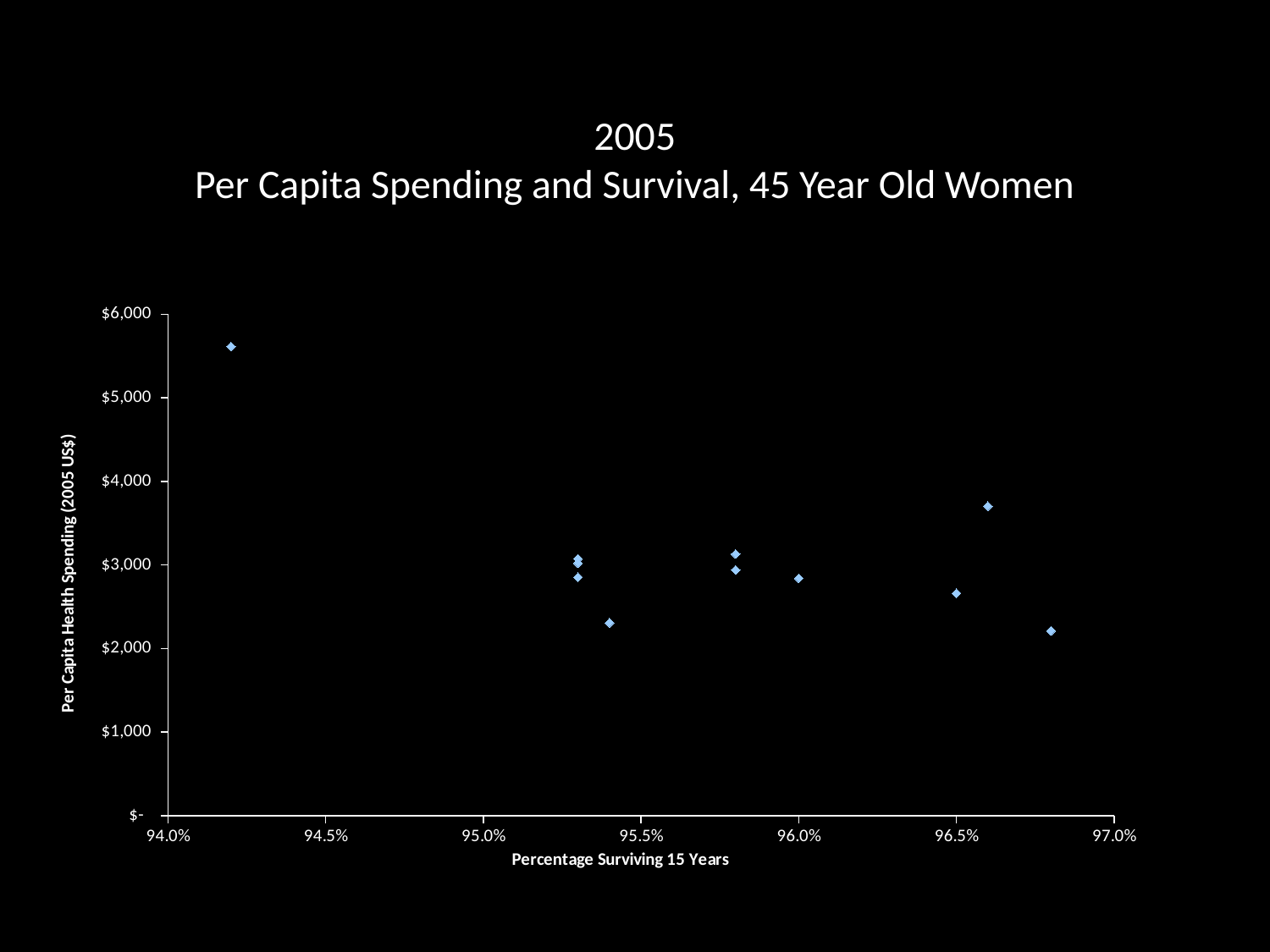
What is the label of the x axis? Percentage Surviving 15 Years Does per capita health spending generally rise or fall as the percentage surviving 15 years increases? Fall Is the per capita health spending for the rightmost point (at about 96.8% survival) greater or less than $3,000? less How many data points are plotted on the chart? 11 Is the per capita health spending for the point at about 96.5% survival greater or less than $3,000? less Is the per capita health spending for the point at about 95.4% survival greater or less than $2,000? greater Which point has the highest per capita health spending: the leftmost point or the rightmost point? The leftmost point What is the title of the chart? 2005 Per Capita Spending and Survival, 45 Year Old Women What kind of chart is shown on the slide? Scatter chart